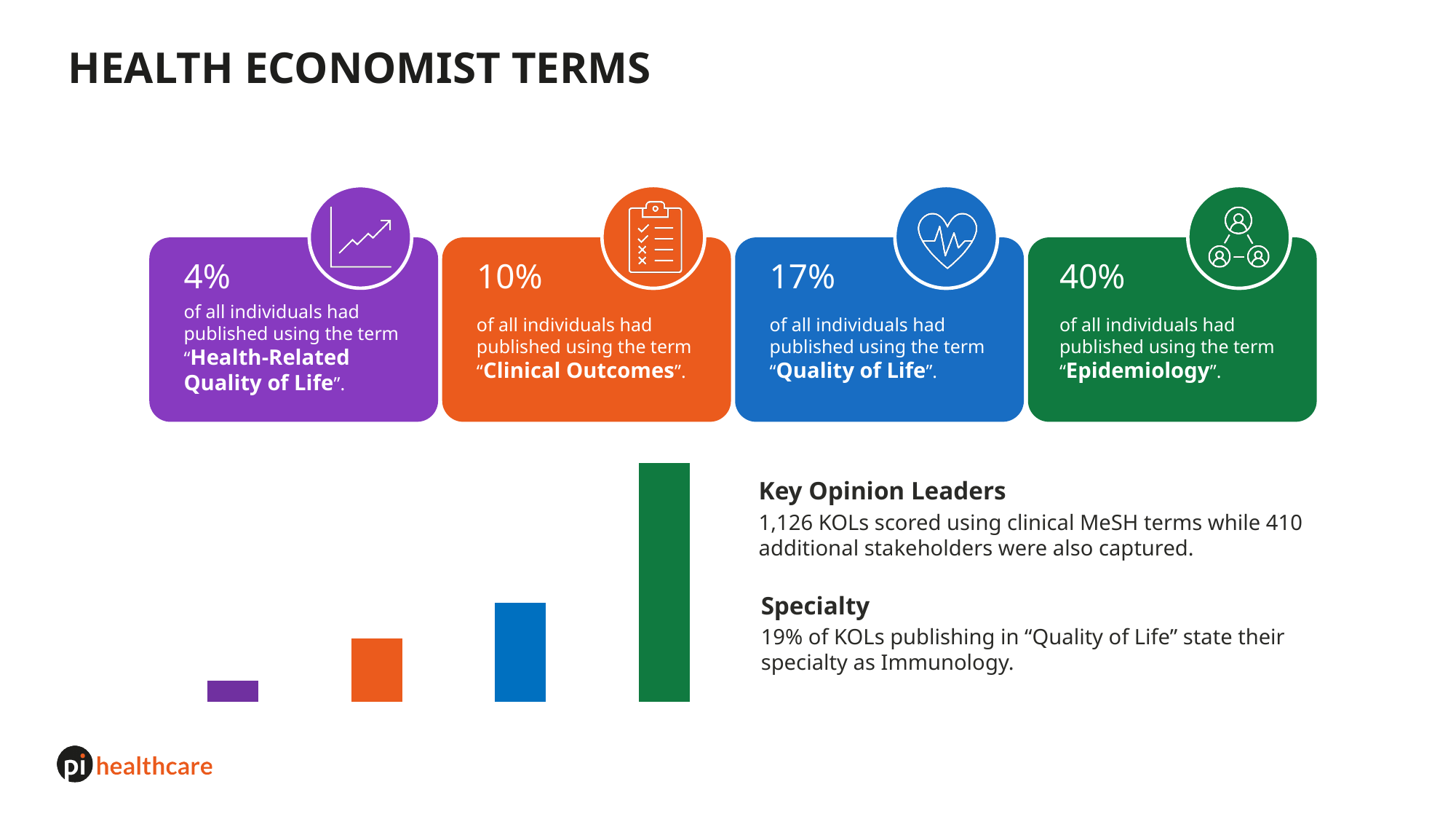
What percentage of individuals had published using the term "Health-Related Quality of Life"? 4% Which is larger: the percentage for "Clinical Outcomes" or for "Quality of Life"? Quality of Life What kind of chart is shown at the bottom left of the slide? bar chart Which term has the lowest percentage of individuals publishing with it? Health-Related Quality of Life What percentage of individuals had published using the term "Quality of Life"? 17% Do the bars in the chart rise or fall from left to right? rise What percentage of individuals had published using the term "Epidemiology"? 40% What colour is the tallest bar in the chart? green What is the difference in percentage points between "Epidemiology" and "Quality of Life"? 23 How many bars does the chart at the bottom left of the slide contain? 4 What percentage of individuals had published using the term "Clinical Outcomes"? 10% Which term has the highest percentage of individuals publishing with it? Epidemiology